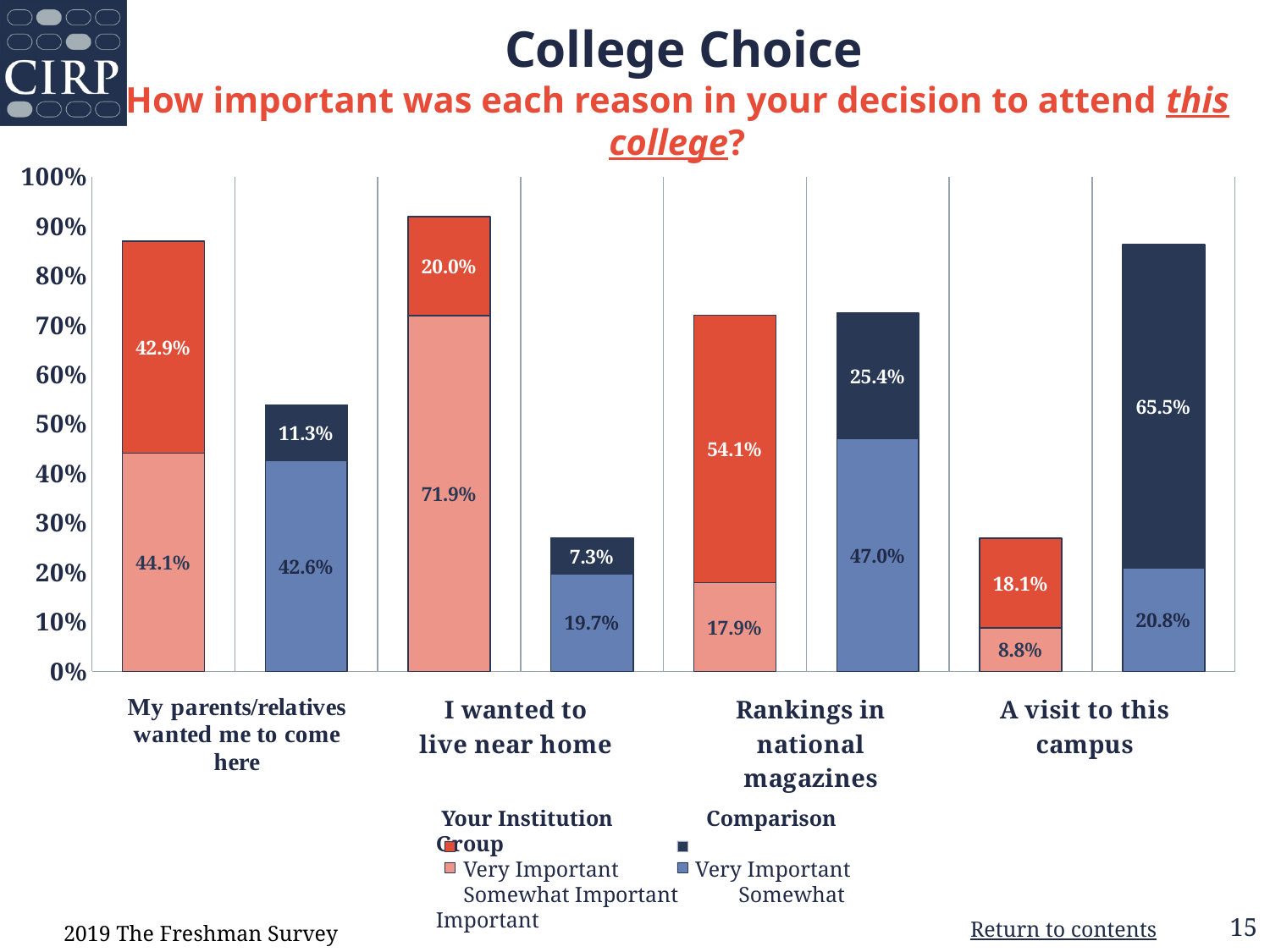
What is the total stacked value of the Comparison Group bar for "A visit to this campus"? 86.3% What percentage of the Comparison Group rated "A visit to this campus" as Very Important? 65.5% How many reasons (categories) are shown on the x axis of the chart? 4 What percentage of the Comparison Group rated "Rankings in national magazines" as Somewhat Important? 47.0% Which reason has the highest Very Important percentage for Your Institution? Rankings in national magazines For "A visit to this campus", which group has the larger Very Important percentage, Your Institution or the Comparison Group? Comparison Group What percentage of Your Institution respondents rated "I wanted to live near home" as Somewhat Important? 71.9% What percentage of Your Institution respondents rated "My parents/relatives wanted me to come here" as Very Important? 42.9% What is the difference between the Very Important percentages for "Rankings in national magazines" between Your Institution and the Comparison Group? 28.7% Which reason has the lowest Very Important percentage for the Comparison Group? I wanted to live near home What is the total stacked value of the Your Institution bar for "I wanted to live near home"? 91.9% What type of chart is shown on the slide? Stacked bar chart